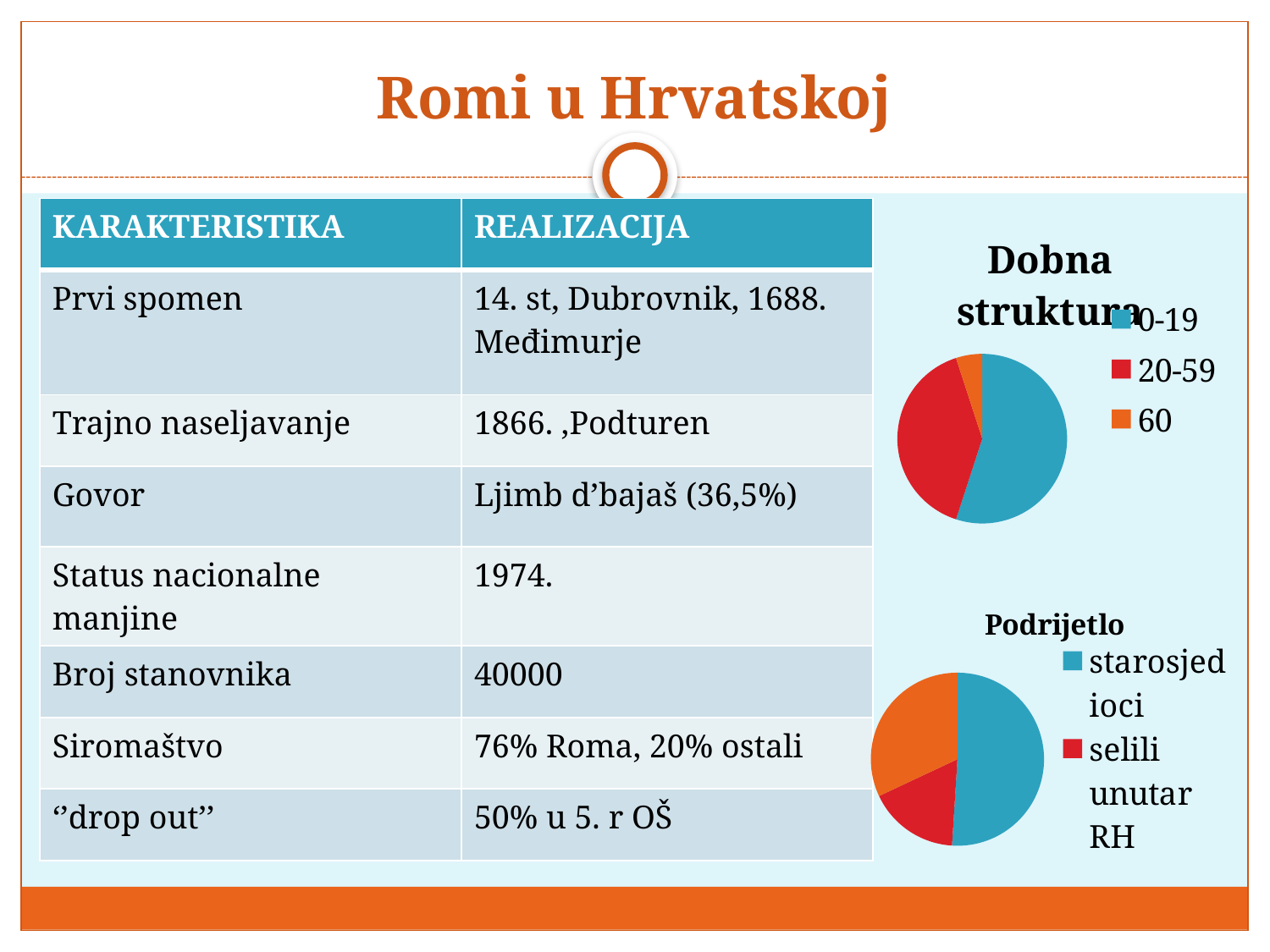
What kind of chart is the "Podrijetlo" chart? pie chart In the "Dobna struktura" chart, how many categories does the legend list? 3 In the "Dobna struktura" chart, which slice is larger, 20-59 or 60? 20-59 In the "Podrijetlo" chart, which category has the largest slice? starosjedioci How many slices does the "Podrijetlo" pie chart have? 3 In the "Podrijetlo" chart, which slice is larger, starosjedioci or selili unutar RH? starosjedioci In the "Dobna struktura" chart, what colour is the 20-59 slice? red In the "Dobna struktura" chart, which slice is larger, 0-19 or 20-59? 0-19 What is the title of the pie chart at the top right of the slide? Dobna struktura What kind of chart is the "Dobna struktura" chart? pie chart In the "Dobna struktura" chart, which age group has the smallest slice? 60 In the "Dobna struktura" chart, which age group has the largest slice? 0-19